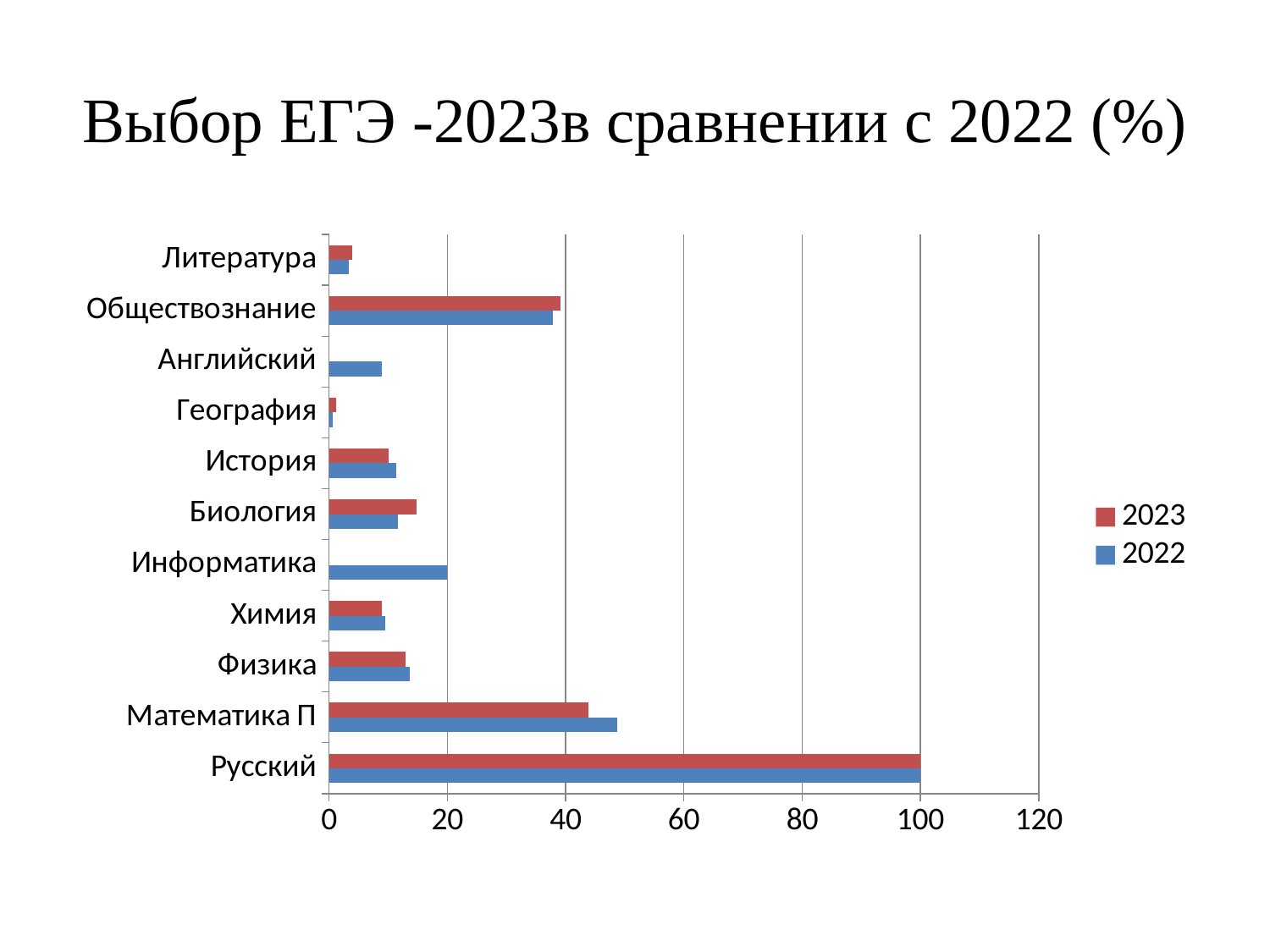
What kind of chart is shown on the slide? bar chart For Математика П, which year has the larger value, 2022 or 2023? 2022 How many subjects (categories) are shown on the chart? 11 What is the value for Русский in 2023? 100 How many series does the legend list? 2 Is the value for Математика П in 2022 greater or less than 40? greater Which subject has the lowest value for 2022? География Which colour represents the 2023 series in the legend? red For Биология, which year has the larger value, 2022 or 2023? 2023 Which subject has the highest value for 2023? Русский